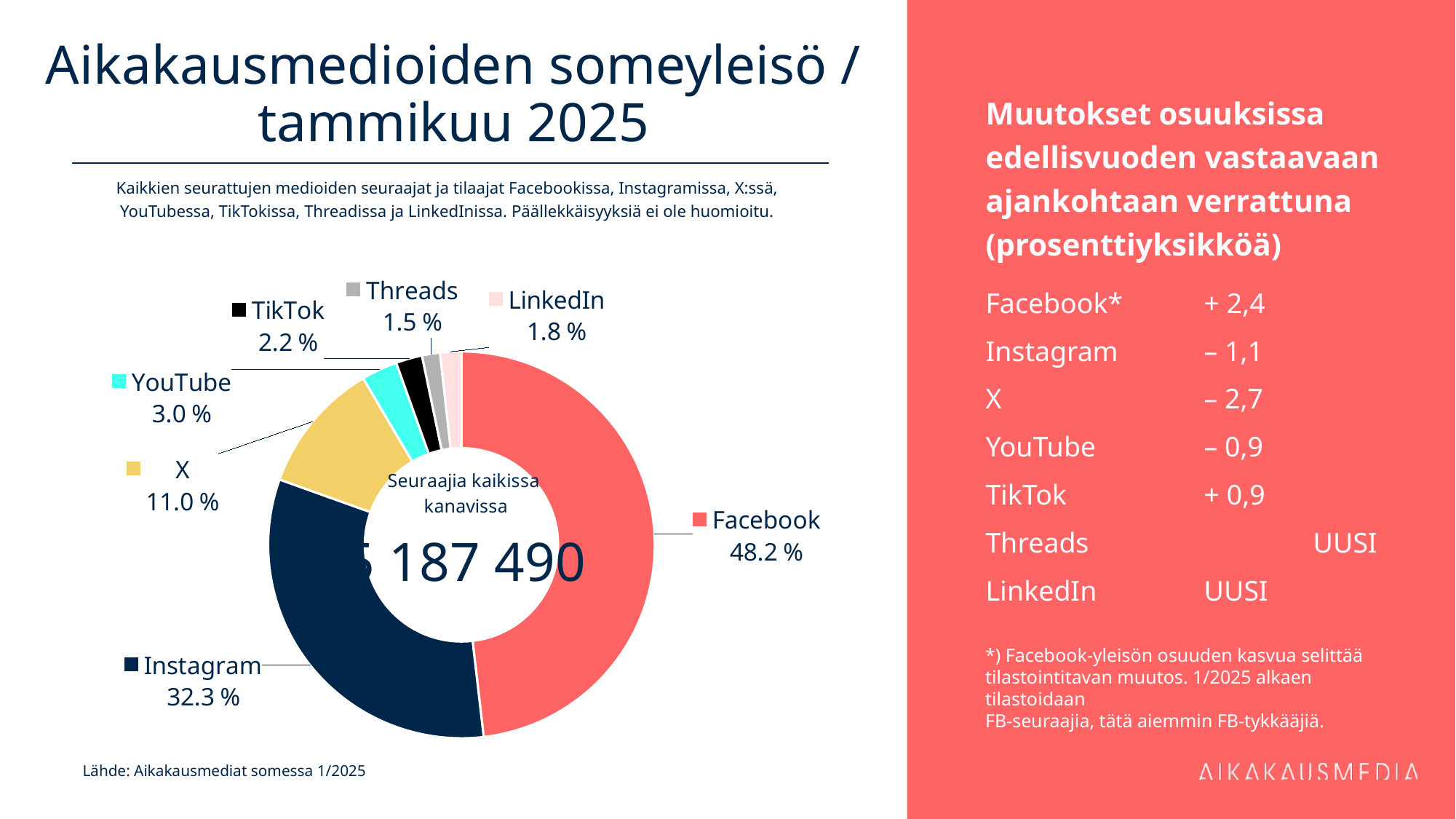
Which platform has the smallest share in the pie chart? Threads What is the share for X in the pie chart? 11.0 % What is the share for Threads? 1.5 % What is the difference in percentage points between Facebook's and Instagram's shares? 15.9 percentage points What kind of chart is shown on the slide? Doughnut (ring) chart What share does YouTube have? 3.0 % How many platforms (slices) are shown in the pie chart? 7 Which platform has the largest share in the pie chart? Facebook What share does Instagram have in the pie chart? 32.3 % Which has a larger share, TikTok or LinkedIn? TikTok What total number of followers across all channels is shown in the centre of the chart? 5 187 490 What share of the social media audience does Facebook have? 48.2 %